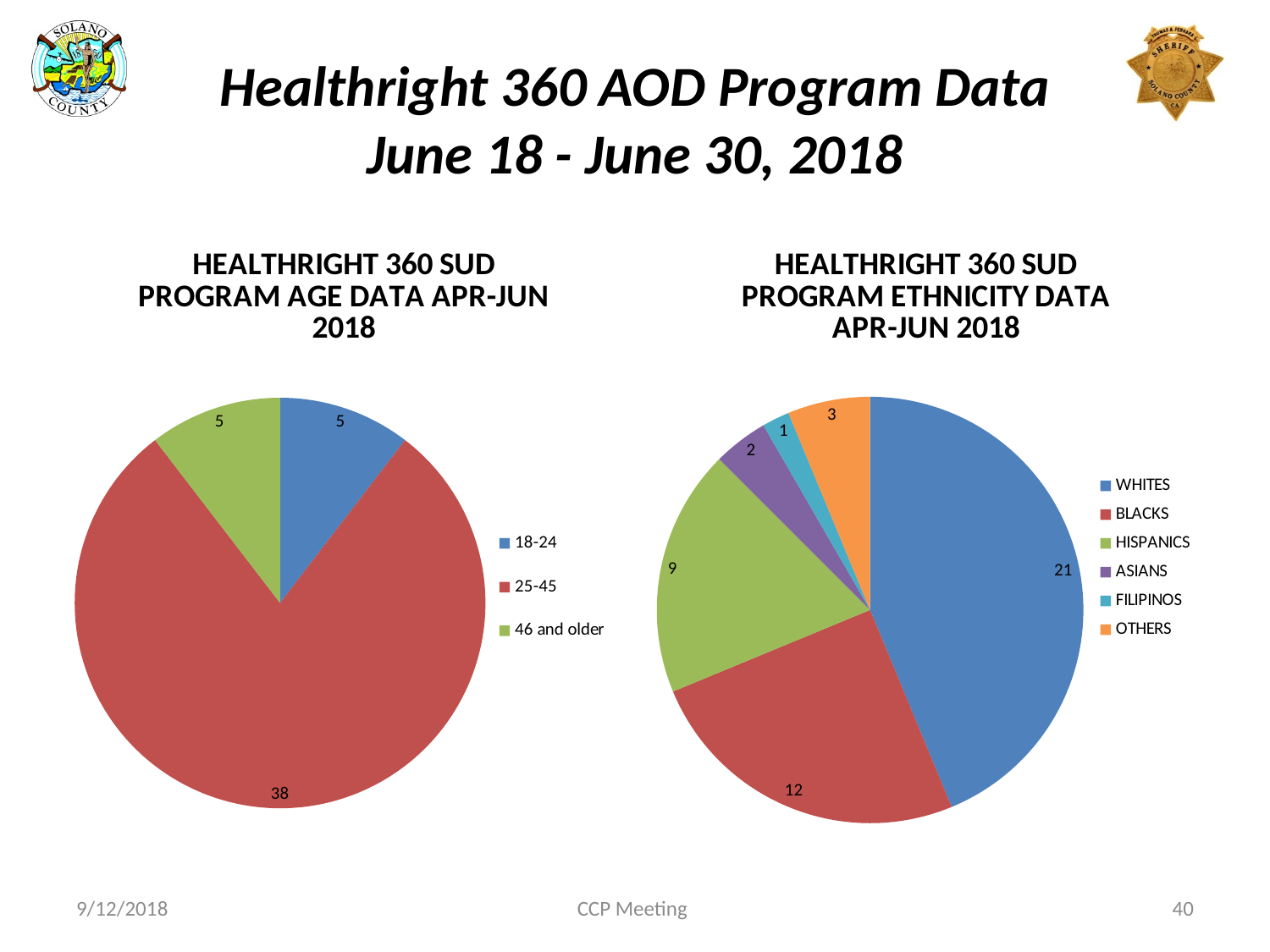
In the ethnicity data pie chart, how many categories does the legend list? 6 What type of chart is used for the ethnicity data? Pie chart In the ethnicity data pie chart, what is the value for HISPANICS? 9 In the ethnicity data pie chart, what is the difference between the WHITES value and the BLACKS value? 9 In the ethnicity data pie chart, which is larger, BLACKS or HISPANICS? BLACKS In the age data pie chart, what is the value for the 46 and older category? 5 In the ethnicity data pie chart, which category has the smallest value? FILIPINOS In the age data pie chart, what is the difference between the 25-45 value and the 18-24 value? 33 In the age data pie chart, how many categories does the legend list? 3 In the age data pie chart, which category has the largest value? 25-45 In the age data pie chart, what is the value for the 25-45 category? 38 In the ethnicity data pie chart, what is the value for FILIPINOS? 1